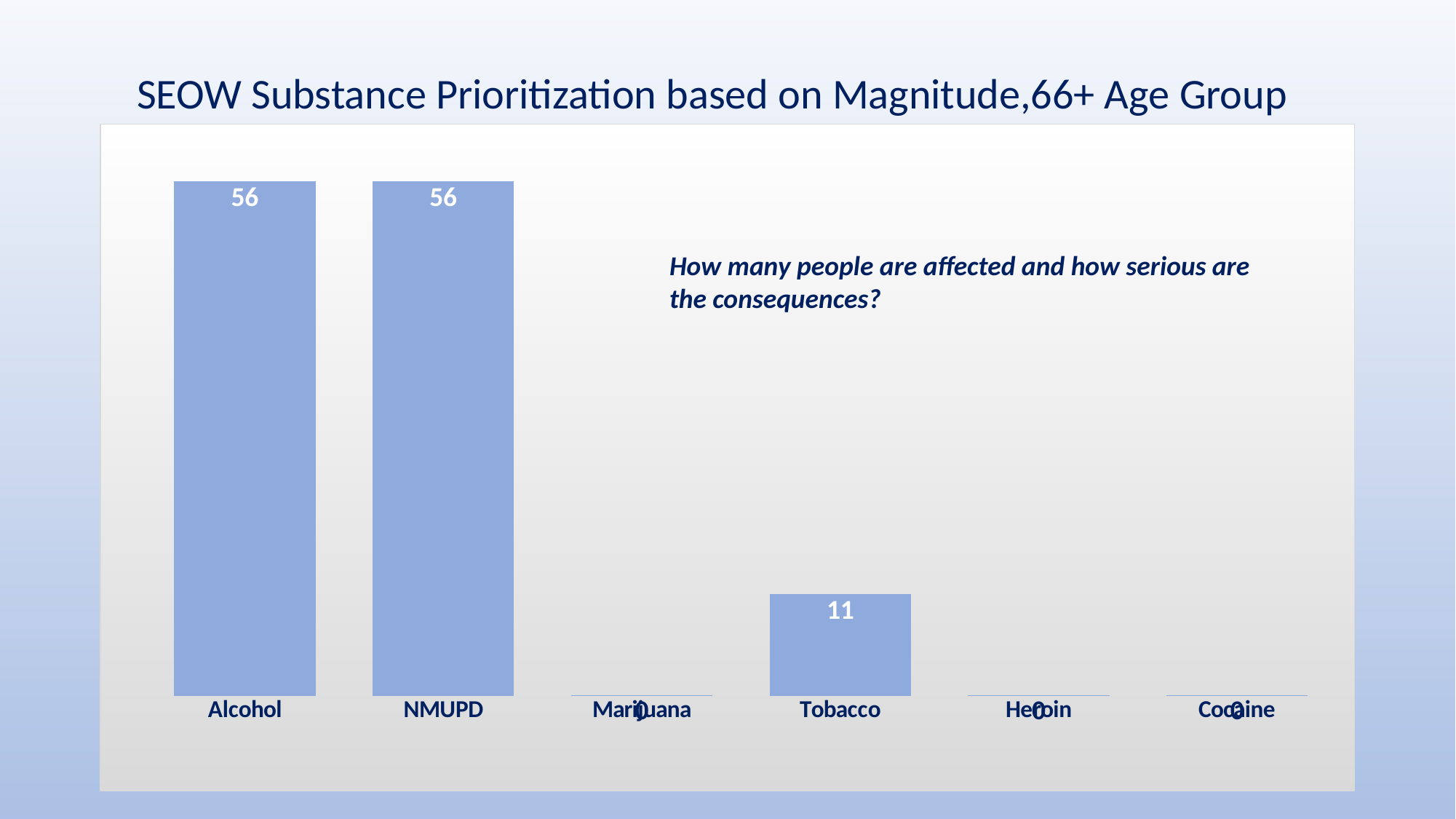
What is the value for NMUPD? 56 Which two categories share the highest value? Alcohol and NMUPD What is the value for Heroin? 0 What is the difference between the values for Alcohol and Tobacco? 45 What is the value for Marijuana? 0 What is the value for Cocaine? 0 What is the title of the slide? SEOW Substance Prioritization based on Magnitude,66+ Age Group What is the value for Tobacco? 11 What is the value for Alcohol? 56 What kind of chart is shown on the slide? Bar chart How many categories are shown on the x axis? 6 Which is larger, the value for Tobacco or the value for Marijuana? Tobacco